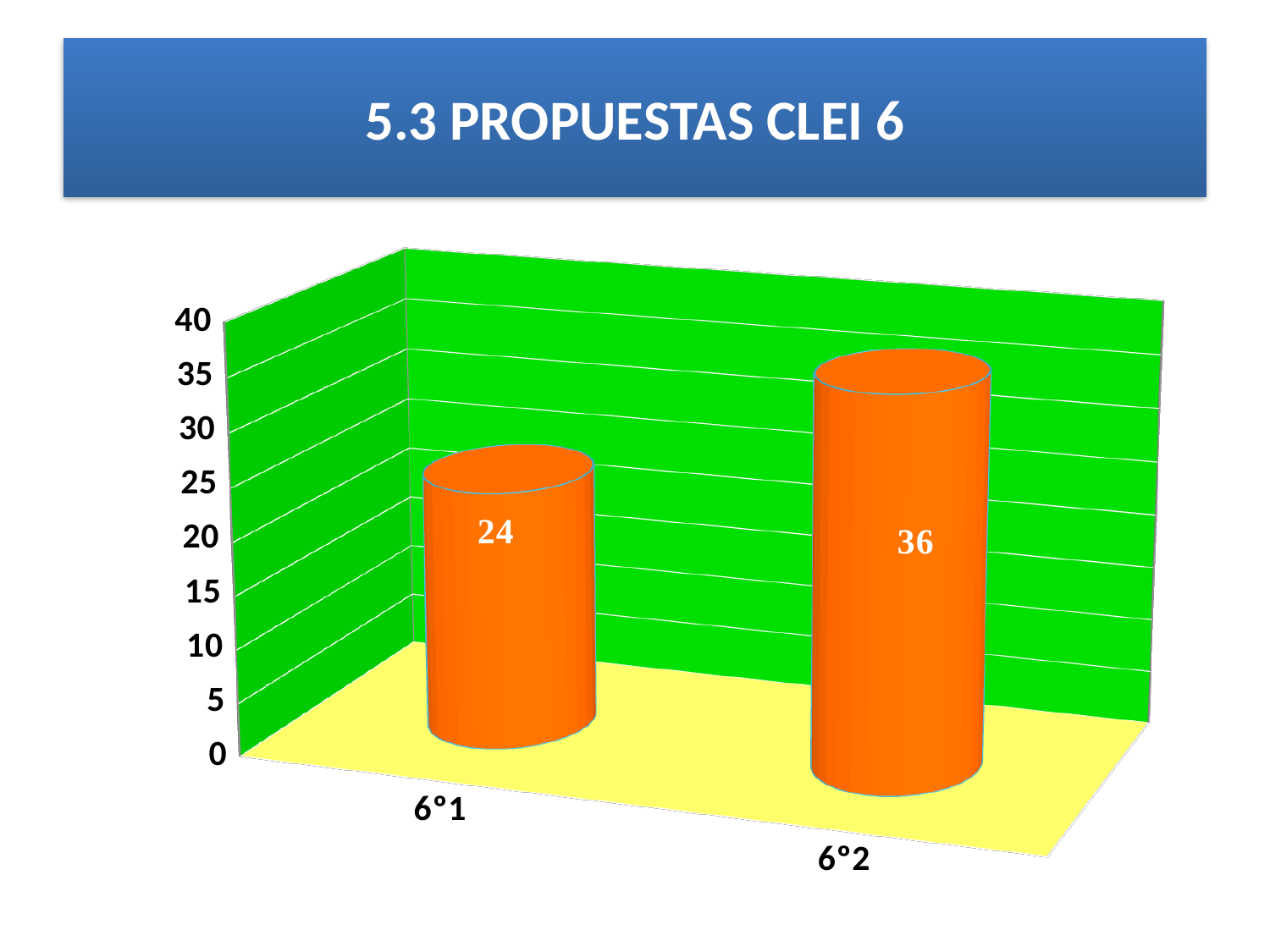
Which category has the highest value? 6°2 How many categories are shown on the chart? 2 Which category has the lowest value? 6°1 What is the title of the slide? 5.3 PROPUESTAS CLEI 6 Is the value for 6°2 greater or less than 30? greater What is the difference between the values for 6°2 and 6°1? 12 What is the value for 6°2? 36 What is the value for 6°1? 24 Which is larger, the value for 6°1 or the value for 6°2? 6°2 Is the value for 6°1 greater or less than 30? less What is the maximum value shown on the vertical axis? 40 What kind of chart is shown on the slide? bar chart